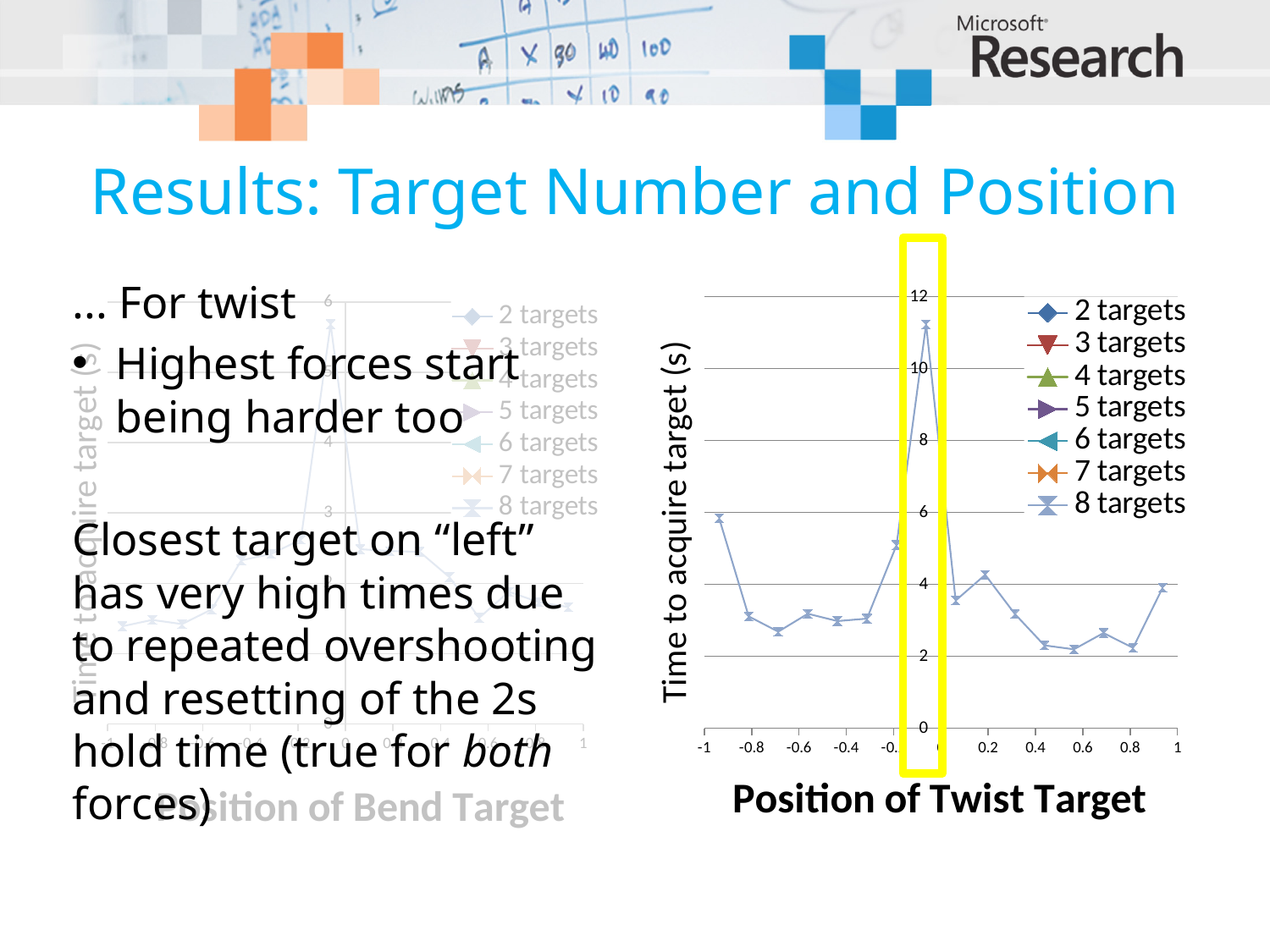
What kind of chart is the faded Position of Bend Target chart on the left? line chart What is the y-axis label of the Position of Twist Target chart? Time to acquire target (s) What kind of chart is the Position of Twist Target chart on the right? line chart On the Position of Twist Target chart, is the value at the rightmost plotted point greater or less than 2? greater What is the x-axis title of the chart on the right of the slide? Position of Twist Target On the Position of Twist Target chart, is the value at the plotted point near 0.6 greater or less than 4? less How many series does the legend of the Position of Twist Target chart list? 7 On the Position of Bend Target chart, is the highest plotted value greater or less than 4? greater On the Position of Twist Target chart, do the values rise or fall from the leftmost point to the point near -0.7? fall How many series does the legend of the Position of Bend Target chart list? 7